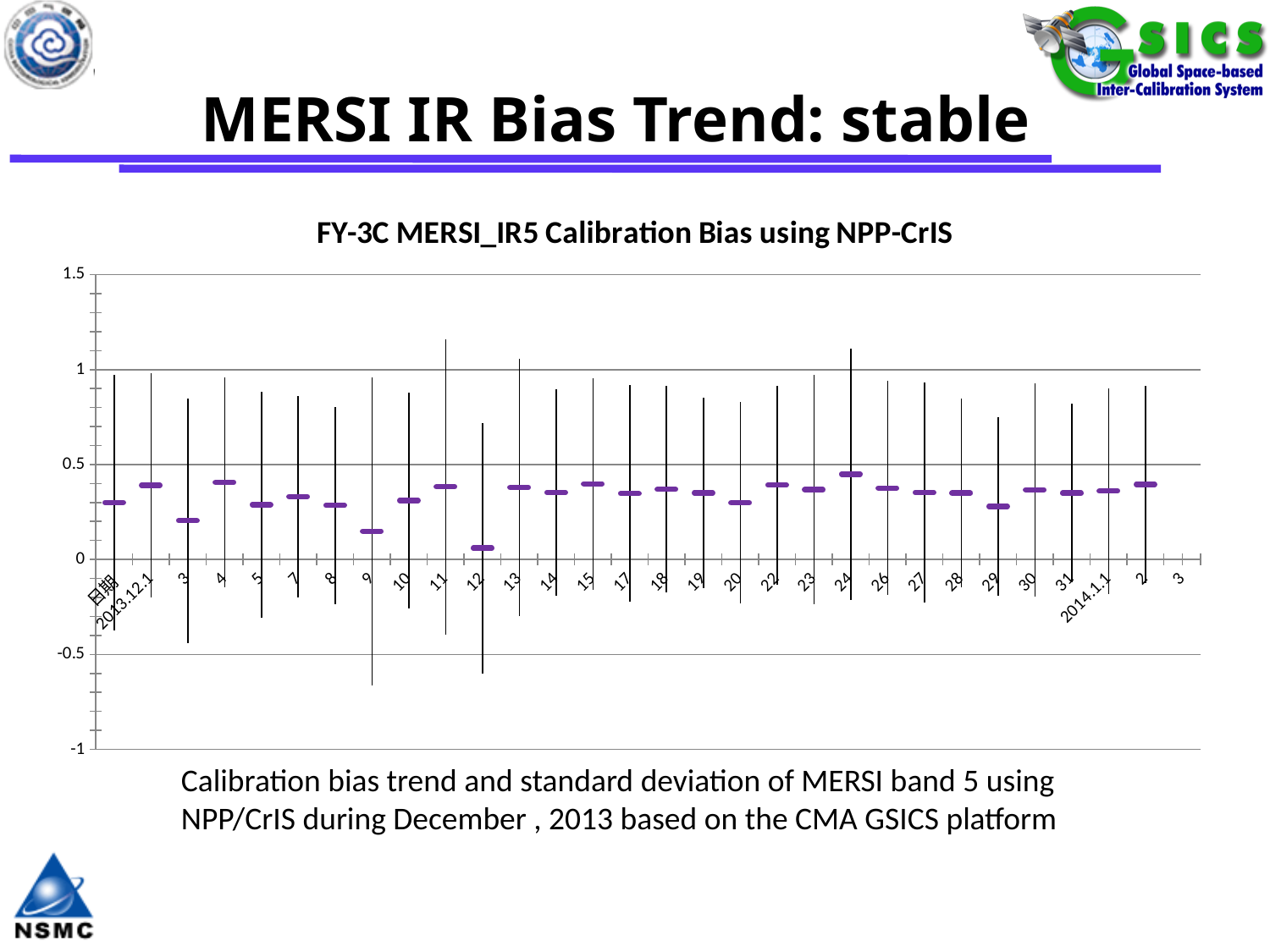
What is the highest value shown on the vertical axis of the chart? 1.5 Do the bias values show a strong rising or falling trend across the dates, or do they stay roughly stable? roughly stable Is the bias value for 2013.12.1 greater or less than 0? greater Which date has the lowest bias marker on the chart? 12 Is the bias value for 4 greater or less than 0? greater Which has the larger bias value, 3 or 4? 4 Which has the larger bias value, 9 or 10? 10 What is the lowest value shown on the vertical axis of the chart? -1 What is the title of the chart? FY-3C MERSI_IR5 Calibration Bias using NPP-CrIS Is the bias value for 9 greater or less than 0.5? less Which has the larger bias value, 12 or 13? 13